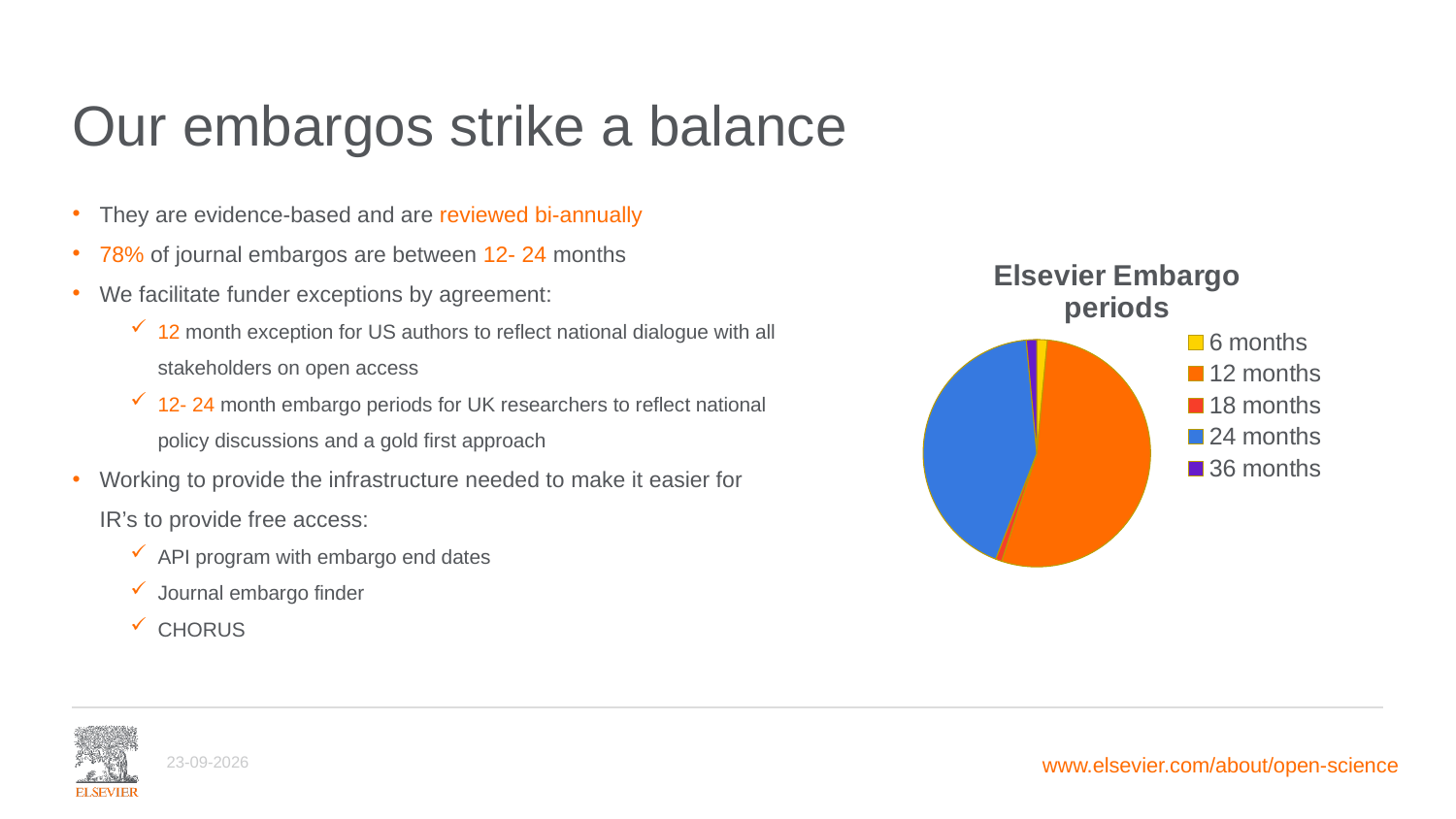
What is the title of the chart? Elsevier Embargo periods How many embargo period categories does the pie chart legend list? 5 Which slice is larger, 12 months or 6 months? 12 months Which embargo period is shown in orange in the pie chart? 12 months What colour represents the 24 months category in the pie chart? blue Which slice is larger, 24 months or 36 months? 24 months Which embargo period has the largest slice of the pie chart? 12 months What kind of chart is shown on the slide? pie chart Which slice is larger, 24 months or 18 months? 24 months How many slices does the pie chart have? 5